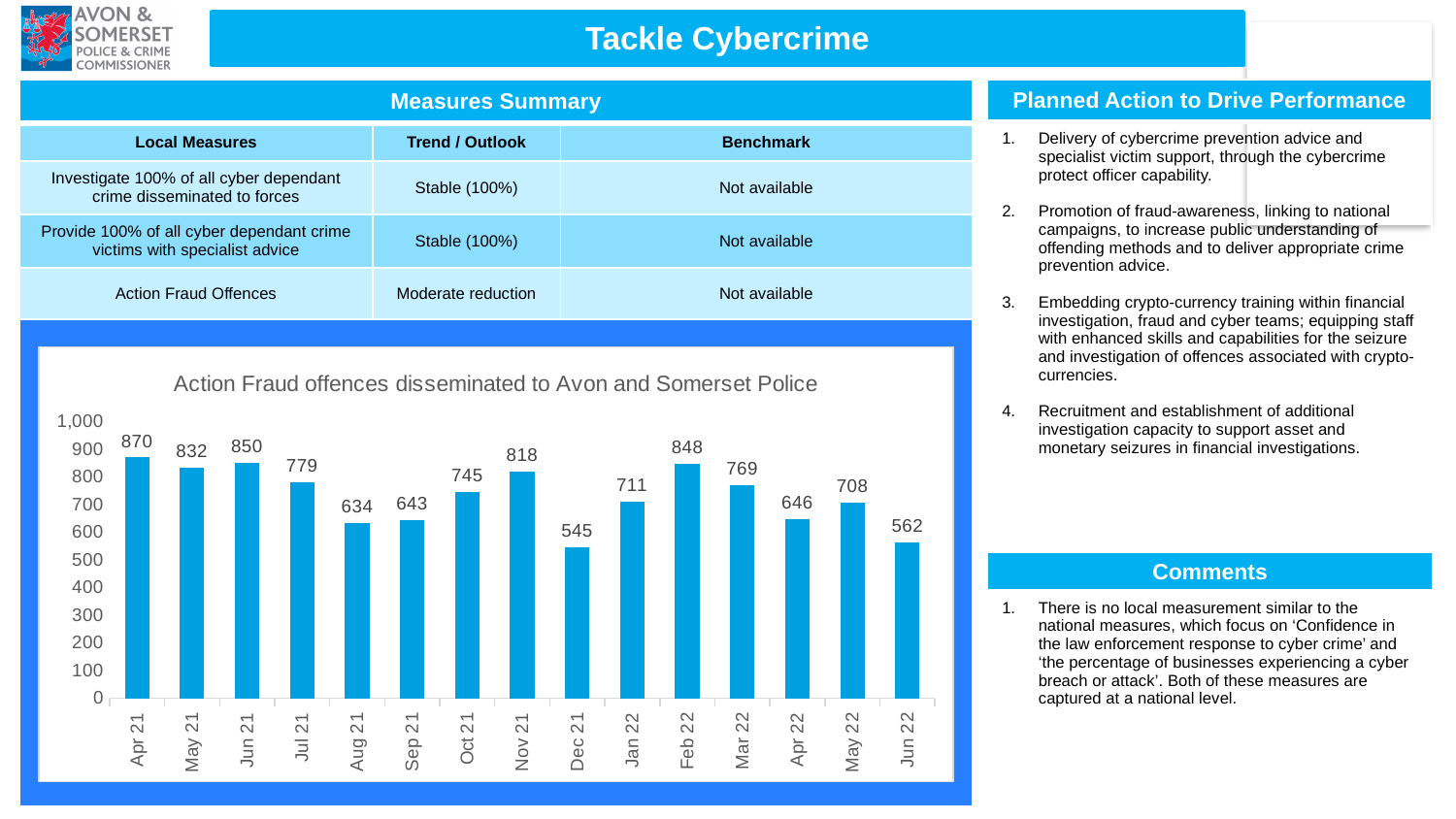
What is the title of the chart? Action Fraud offences disseminated to Avon and Somerset Police What kind of chart is used to show Action Fraud offences? bar chart Do the values rise or fall from Feb 22 to Jun 22? fall Which month has the lowest number of Action Fraud offences disseminated? Dec 21 How many months are shown on the x axis of the chart? 15 Which is larger, the value for Nov 21 or the value for Mar 22? Nov 21 Is the value for Aug 21 greater or less than 700? less What is the difference between the values for Apr 21 and Jun 22? 308 Which month has the highest number of Action Fraud offences disseminated? Apr 21 What is the value for Apr 21 in the Action Fraud offences chart? 870 What is the value for Feb 22 in the Action Fraud offences chart? 848 What is the value for Dec 21 in the Action Fraud offences chart? 545